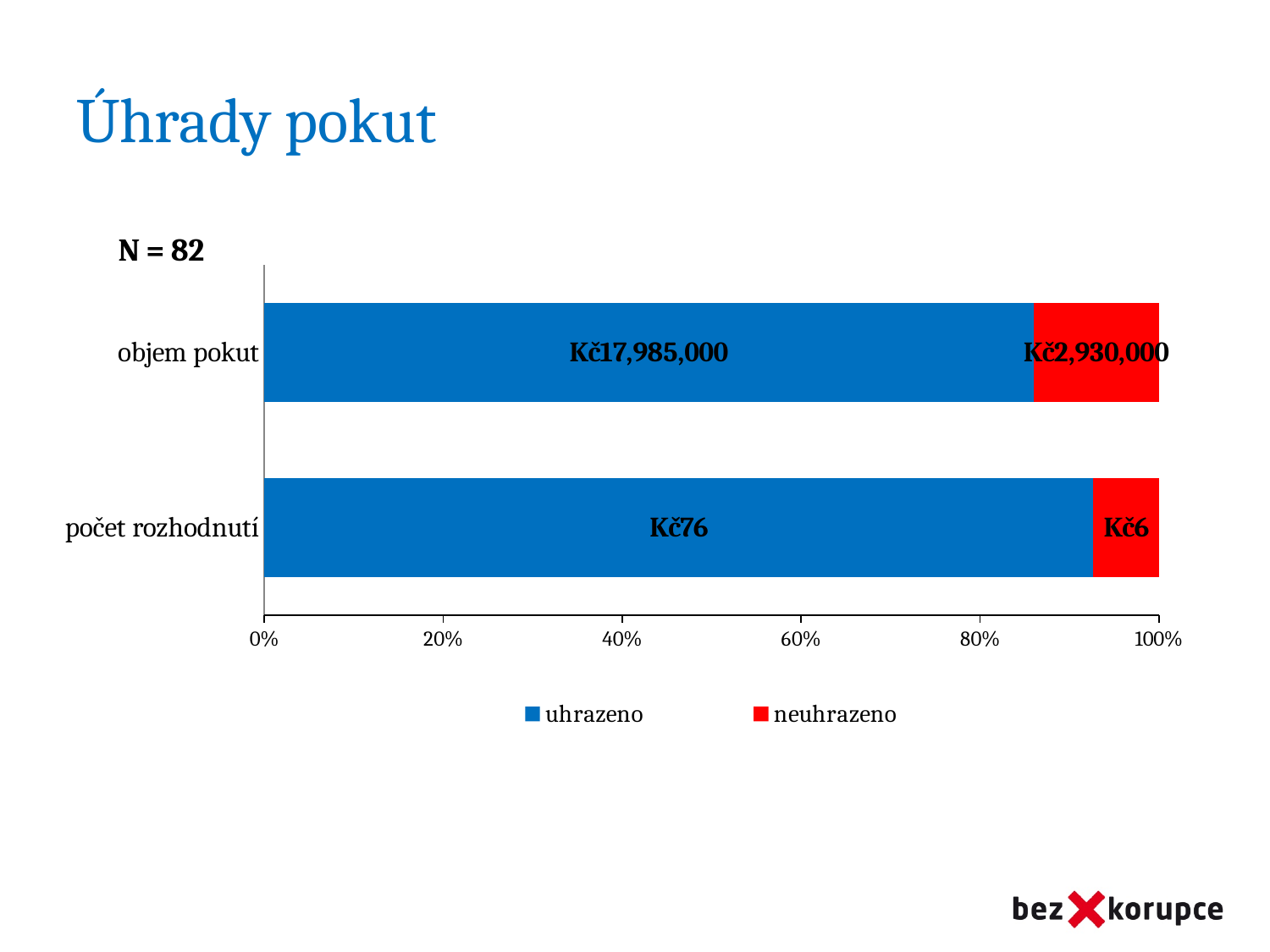
Is the 'uhrazeno' share of the 'objem pokut' bar greater or less than 80%? greater What is the total of the two segments in the 'počet rozhodnutí' bar? 82 Is the 'uhrazeno' share of the 'počet rozhodnutí' bar greater or less than 80%? greater What kind of chart is shown on the slide? Stacked bar chart What is the value of the 'neuhrazeno' segment for 'objem pokut'? Kč2,930,000 What is the difference between the 'uhrazeno' and 'neuhrazeno' values for 'počet rozhodnutí'? 70 What is the value of the 'uhrazeno' segment for 'objem pokut'? Kč17,985,000 How many series does the legend list? 2 What is the value of the 'uhrazeno' segment for 'počet rozhodnutí'? Kč76 How many categories are shown on the chart? 2 What is the value of the 'neuhrazeno' segment for 'počet rozhodnutí'? Kč6 Which segment is larger for 'objem pokut', 'uhrazeno' or 'neuhrazeno'? uhrazeno